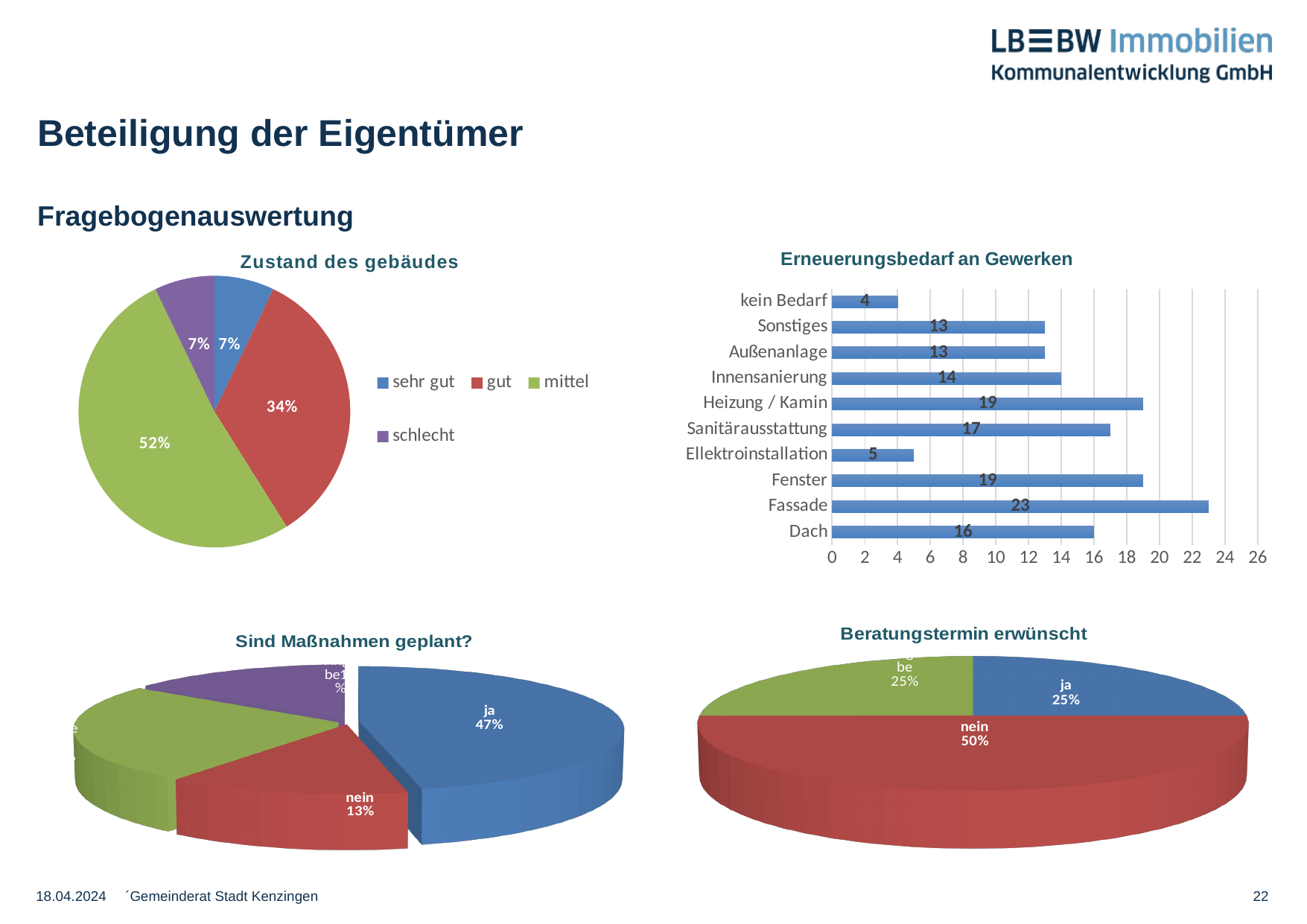
What kind of chart is "Erneuerungsbedarf an Gewerken"? Bar chart In the "Zustand des gebäudes" chart, what share is labelled "mittel"? 52% In the "Erneuerungsbedarf an Gewerken" chart, how many categories are shown? 10 In the "Erneuerungsbedarf an Gewerken" chart, what is the difference between Fassade and Dach? 7 In the "Zustand des gebäudes" chart, how many entries does the legend list? 4 In the "Zustand des gebäudes" chart, what share is labelled "gut"? 34% In the "Erneuerungsbedarf an Gewerken" chart, what is the value for Fassade? 23 In the "Erneuerungsbedarf an Gewerken" chart, which category has the lowest value? kein Bedarf In the "Erneuerungsbedarf an Gewerken" chart, which category has the highest value? Fassade In the "Erneuerungsbedarf an Gewerken" chart, what is the value for Sanitärausstattung? 17 In the "Erneuerungsbedarf an Gewerken" chart, which is larger, Innensanierung or Ellektroinstallation? Innensanierung In the "Beratungstermin erwünscht" chart, what share is labelled "nein"? 50%